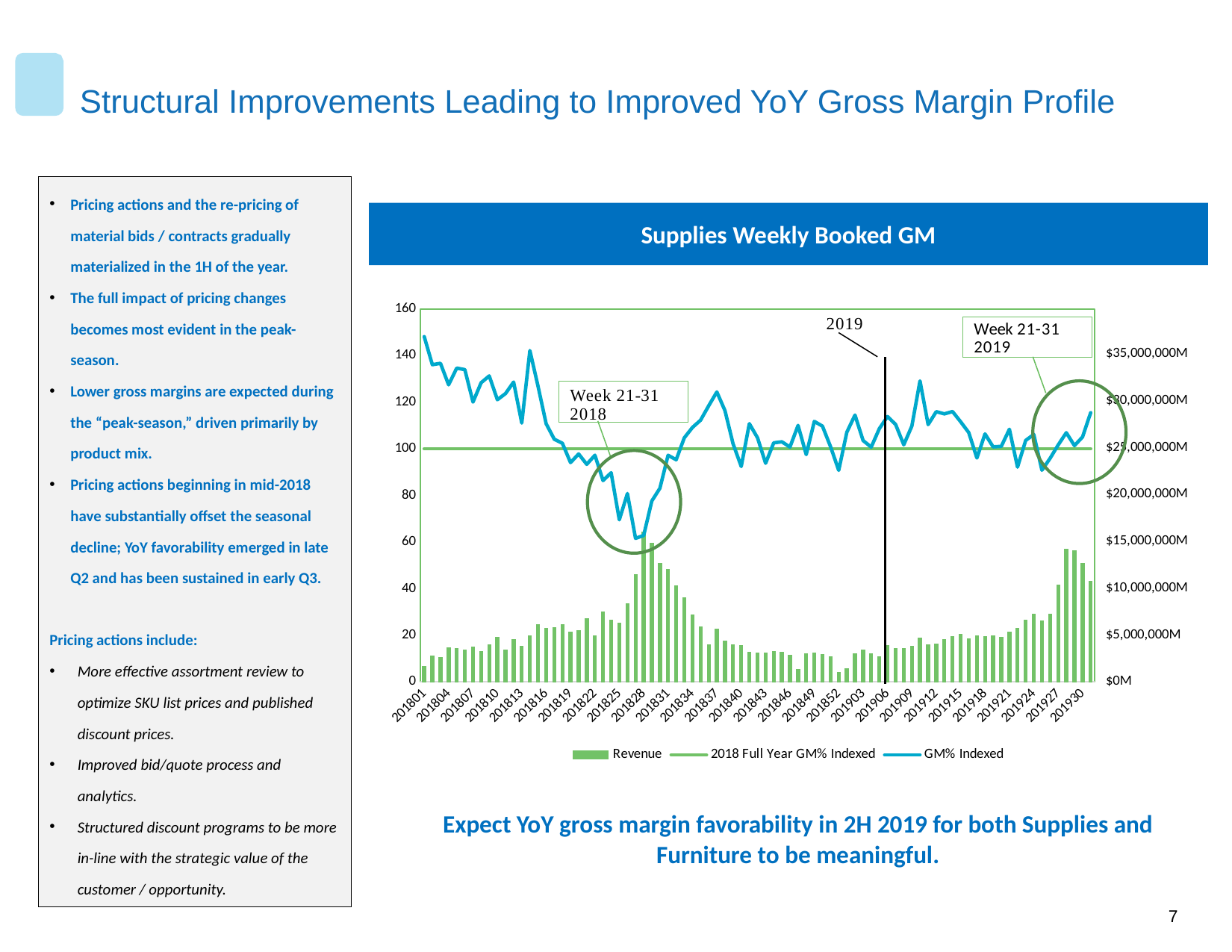
At what value does the flat 2018 Full Year GM% Indexed line sit on the left axis? 100 Is the GM% Indexed value at week 201801 greater or less than 120? greater What is the highest value shown on the left vertical axis? 160 Is the GM% Indexed value at week 201828 greater or less than 80? less What kind of chart is shown on the slide? Combination bar and line chart Does the GM% Indexed line rise or fall from week 201801 to week 201828? fall What is the title of the chart? Supplies Weekly Booked GM Which is larger, the GM% Indexed value at week 201801 or at week 201828? 201801 How many series does the chart legend list? 3 Is the tallest Revenue bar greater or less than $10,000,000M? greater